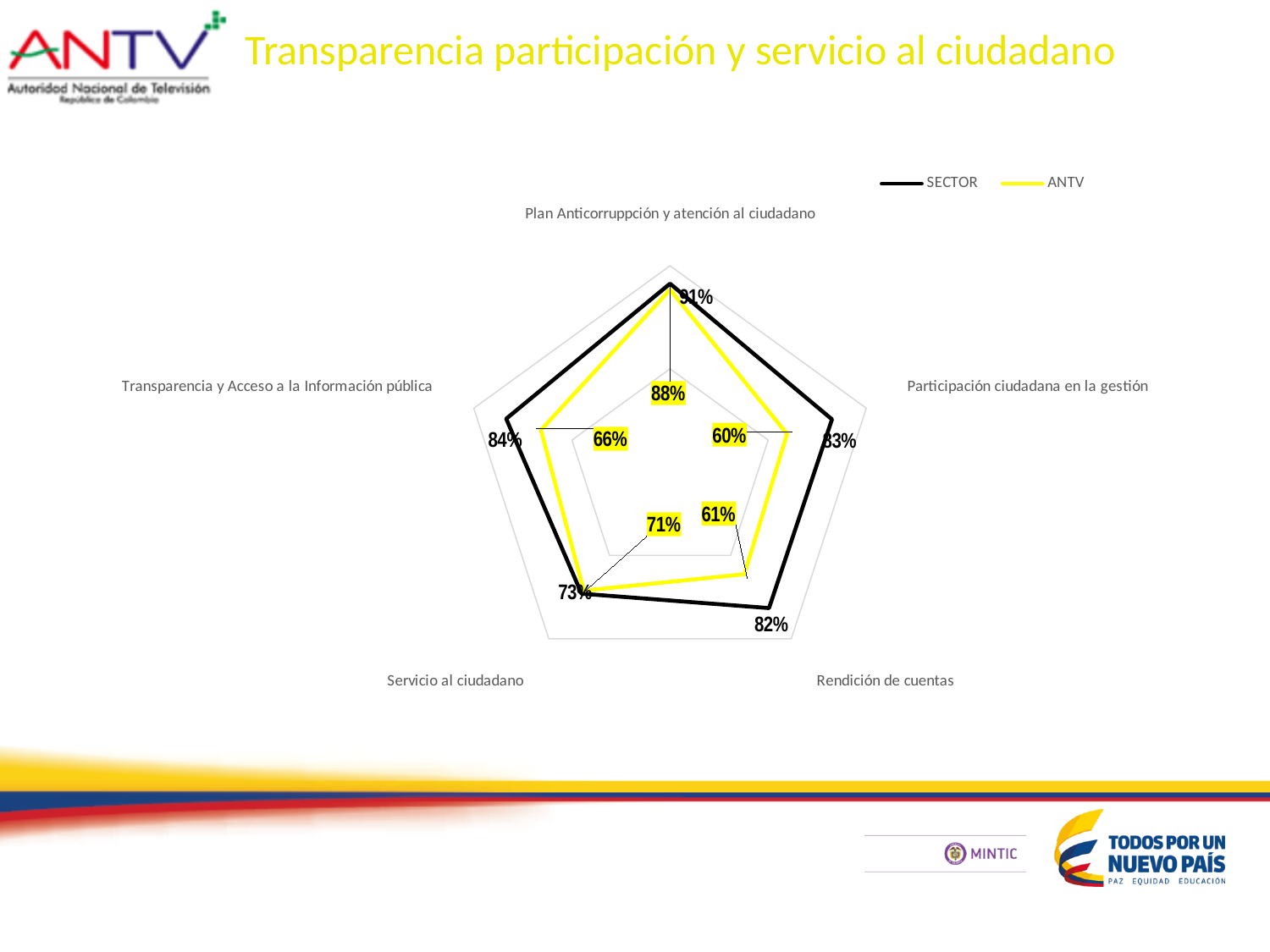
What is the SECTOR value for Rendición de cuentas? 82% What is the SECTOR value for Plan Anticorruppción y atención al ciudadano? 91% What is the ANTV value for Participación ciudadana en la gestión? 60% Which series is drawn in yellow? ANTV Which category has the highest SECTOR value? Plan Anticorruppción y atención al ciudadano What is the ANTV value for Servicio al ciudadano? 71% How many series does the legend list? 2 What is the ANTV value for Plan Anticorruppción y atención al ciudadano? 88% What is the difference between the SECTOR and ANTV values for Transparencia y Acceso a la Información pública? 18% Which category has the lowest ANTV value? Participación ciudadana en la gestión What kind of chart is shown on the slide? Radar chart How many categories (axes) does the radar chart have? 5